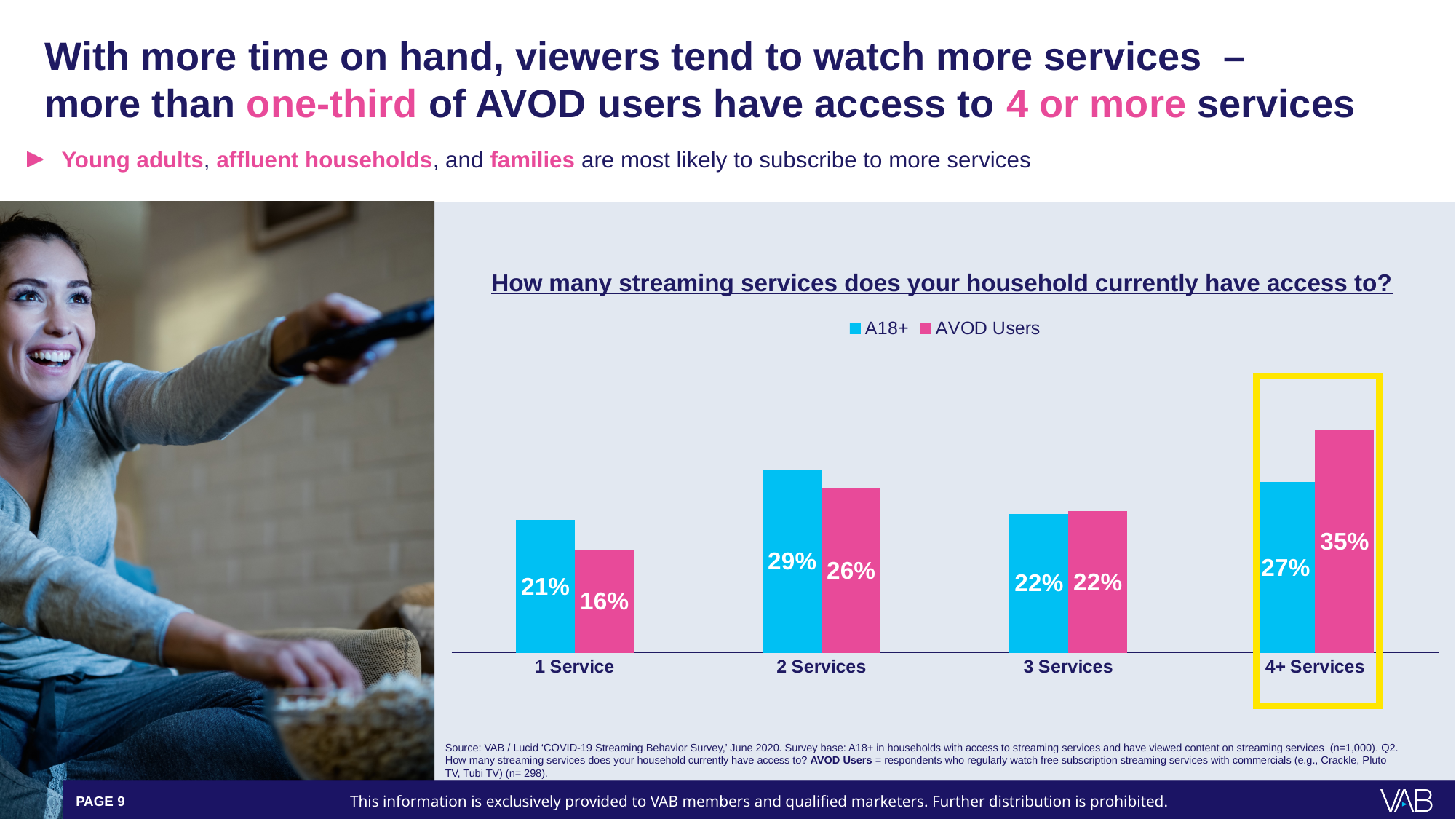
Which category is highlighted with a yellow box? 4+ Services How many series does the legend list? 2 What is the title of the chart? How many streaming services does your household currently have access to? What percentage of AVOD Users have access to 4+ Services? 35% For 1 Service, which series has the larger value, A18+ or AVOD Users? A18+ What is the AVOD Users value for 1 Service? 16% What kind of chart is shown on the slide? Bar chart What is the difference between the AVOD Users and A18+ values for 4+ Services? 8% What is the A18+ value for 2 Services? 29% Which category has the highest value for AVOD Users? 4+ Services How many categories are shown on the x axis? 4 Which category has the lowest value for A18+? 1 Service